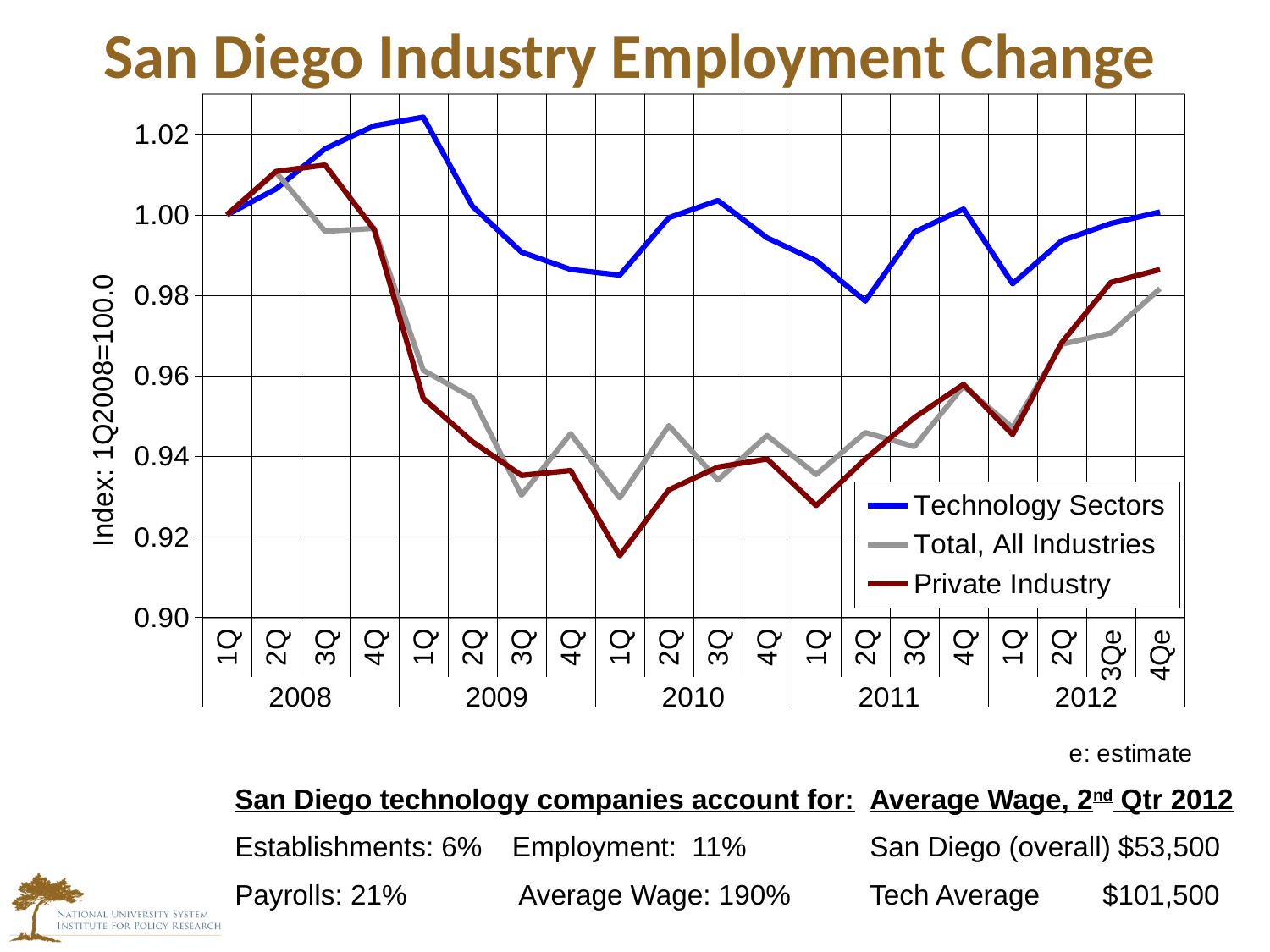
How many quarterly points are plotted along the x axis? 20 How many series does the legend list? 3 Is the value for Private Industry in 1Q 2010 greater or less than 0.92? less What is the index value for Technology Sectors in 1Q 2008? 1.00 What type of chart is shown on the slide? Line chart Is the value for Private Industry in 1Q 2009 greater or less than 0.96? less In which quarter does the Technology Sectors line reach its highest value? 1Q 2009 In which quarter does the Private Industry line reach its lowest value? 1Q 2010 Does the Private Industry line rise or fall from 1Q 2012 to 4Qe 2012? Rises What is the label on the y axis? Index: 1Q2008=100.0 Is the value for Total, All Industries in 3Q 2009 greater or less than 0.92? greater In 1Q 2010, which series has the higher value: Technology Sectors or Private Industry? Technology Sectors